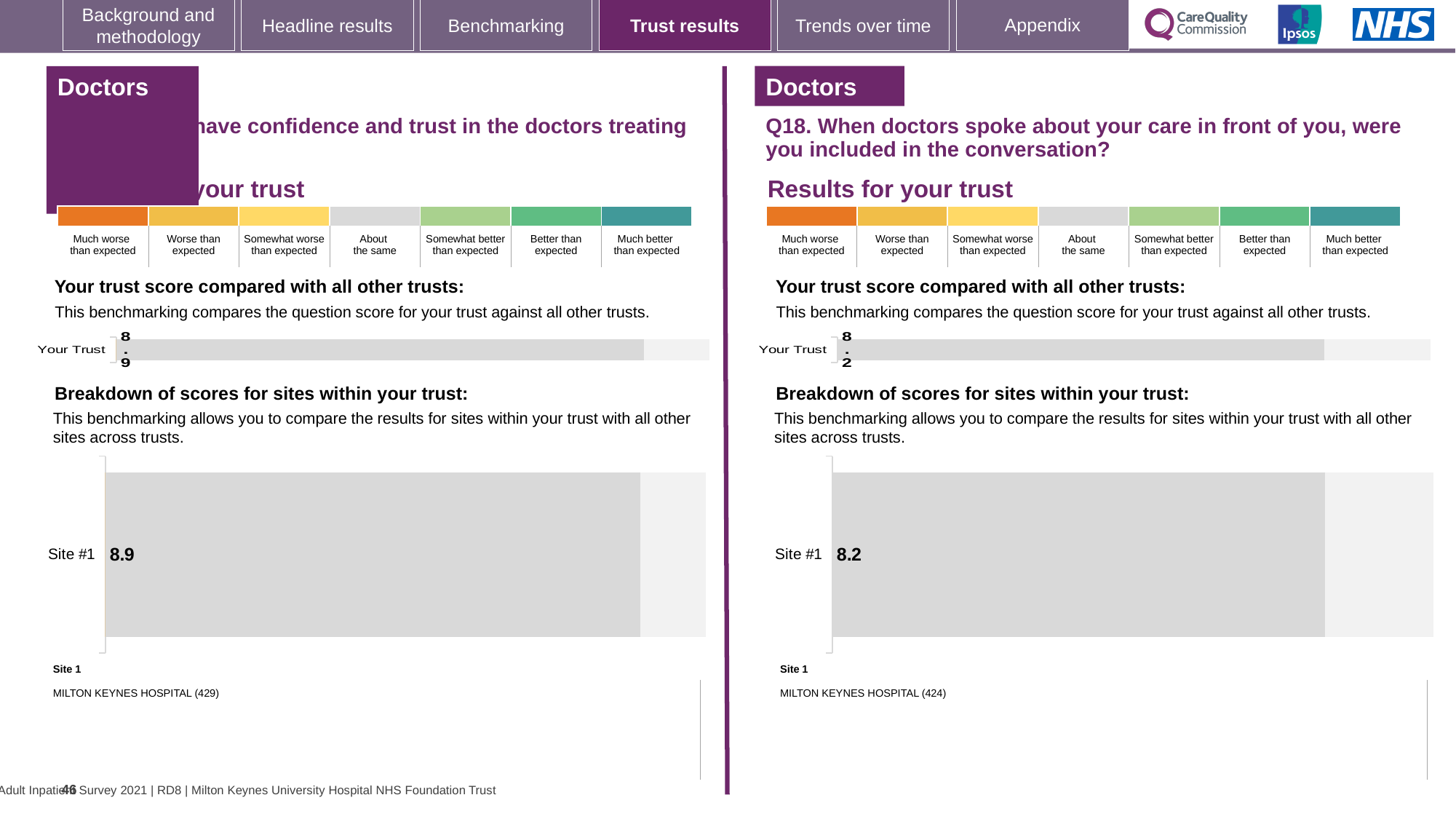
On the left half of the slide, what is the score shown for Your Trust in the 'Your trust score compared with all other trusts' chart? 8.9 What type of chart is used to show the Site #1 score in the breakdown section on the right half of the slide? Bar chart How many sites are shown in the left 'Breakdown of scores for sites within your trust' chart? 1 In the right (Q18) 'Breakdown of scores for sites within your trust' chart, what is the score for Site #1? 8.2 What is the difference between the Site #1 score on the left chart and the Site #1 score on the right (Q18) chart? 0.7 Which is larger: the Your Trust score on the left half of the slide or the Your Trust score on the right half (Q18)? Left (8.9) Which hospital is listed as Site 1 under the left breakdown chart? MILTON KEYNES HOSPITAL (429) Is the Site #1 score in the left breakdown chart equal to the Your Trust score on the left half of the slide? Yes, both are 8.9 On the right half of the slide (Q18), what is the score shown for Your Trust in the 'Your trust score compared with all other trusts' chart? 8.2 Which hospital is listed as Site 1 under the right (Q18) breakdown chart? MILTON KEYNES HOSPITAL (424) In the left 'Breakdown of scores for sites within your trust' chart, what is the score for Site #1? 8.9 How many sites are shown in the right (Q18) 'Breakdown of scores for sites within your trust' chart? 1